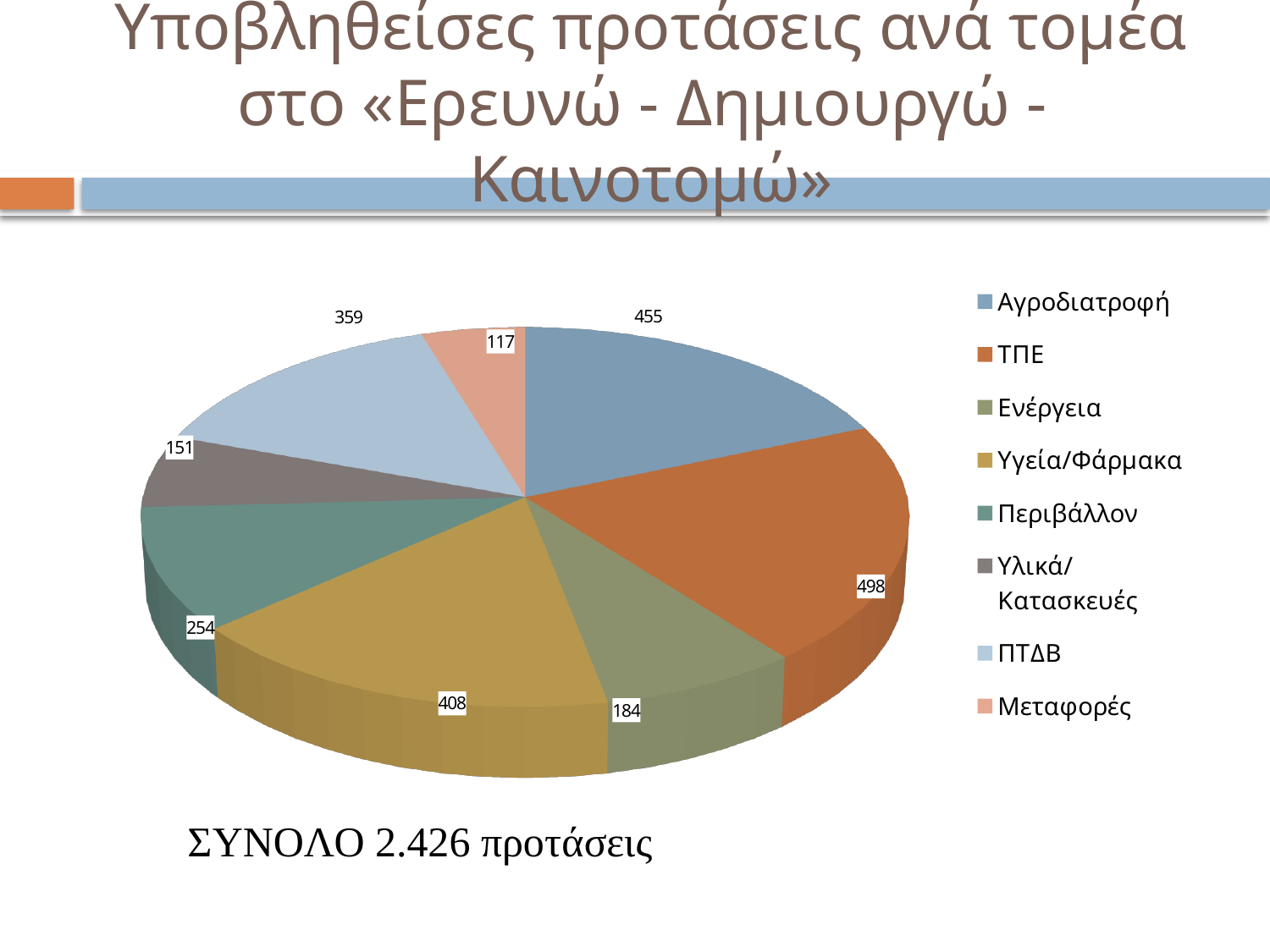
What kind of chart is shown on the slide? pie chart What is the total number of proposals stated on the slide? 2.426 προτάσεις What is the value shown for Αγροδιατροφή? 455 What is the difference between the values for ΤΠΕ and Αγροδιατροφή? 43 Which has more submitted proposals, Περιβάλλον or Ενέργεια? Περιβάλλον How many sectors (slices) does the pie chart show? 8 How many proposals were submitted in the ΤΠΕ sector? 498 What is the value shown for Υγεία/Φάρμακα? 408 Which sector has the largest number of submitted proposals? ΤΠΕ What is the value shown for Μεταφορές? 117 Which sector has the smallest number of submitted proposals? Μεταφορές Which legend entry is shown in light blue? ΠΤΔΒ